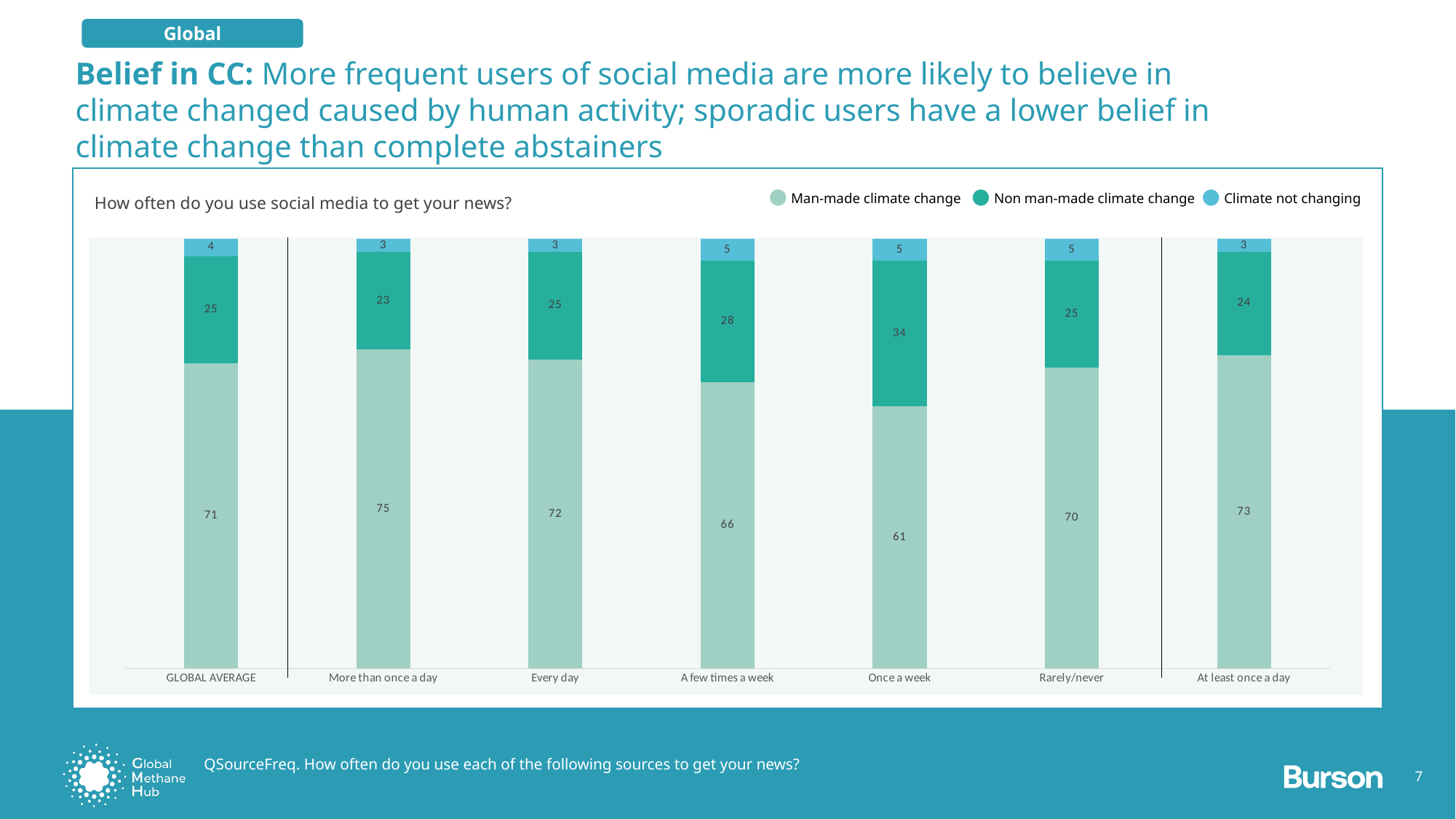
How many series does the legend list? 3 Is the Man-made climate change value larger for Rarely/never or for At least once a day? At least once a day What kind of chart is shown? Stacked bar chart What is the difference between the Man-made climate change values for More than once a day and Once a week? 14 What is the value for Non man-made climate change in the A few times a week category? 28 What is the total of the stacked bar for Every day? 100 Which category has the highest value for Non man-made climate change? Once a week What is the value for Man-made climate change in the Once a week category? 61 How many categories are shown on the x axis? 7 Which category has the lowest value for Man-made climate change? Once a week Which category has the highest value for Man-made climate change? More than once a day What is the value for Climate not changing in the GLOBAL AVERAGE category? 4